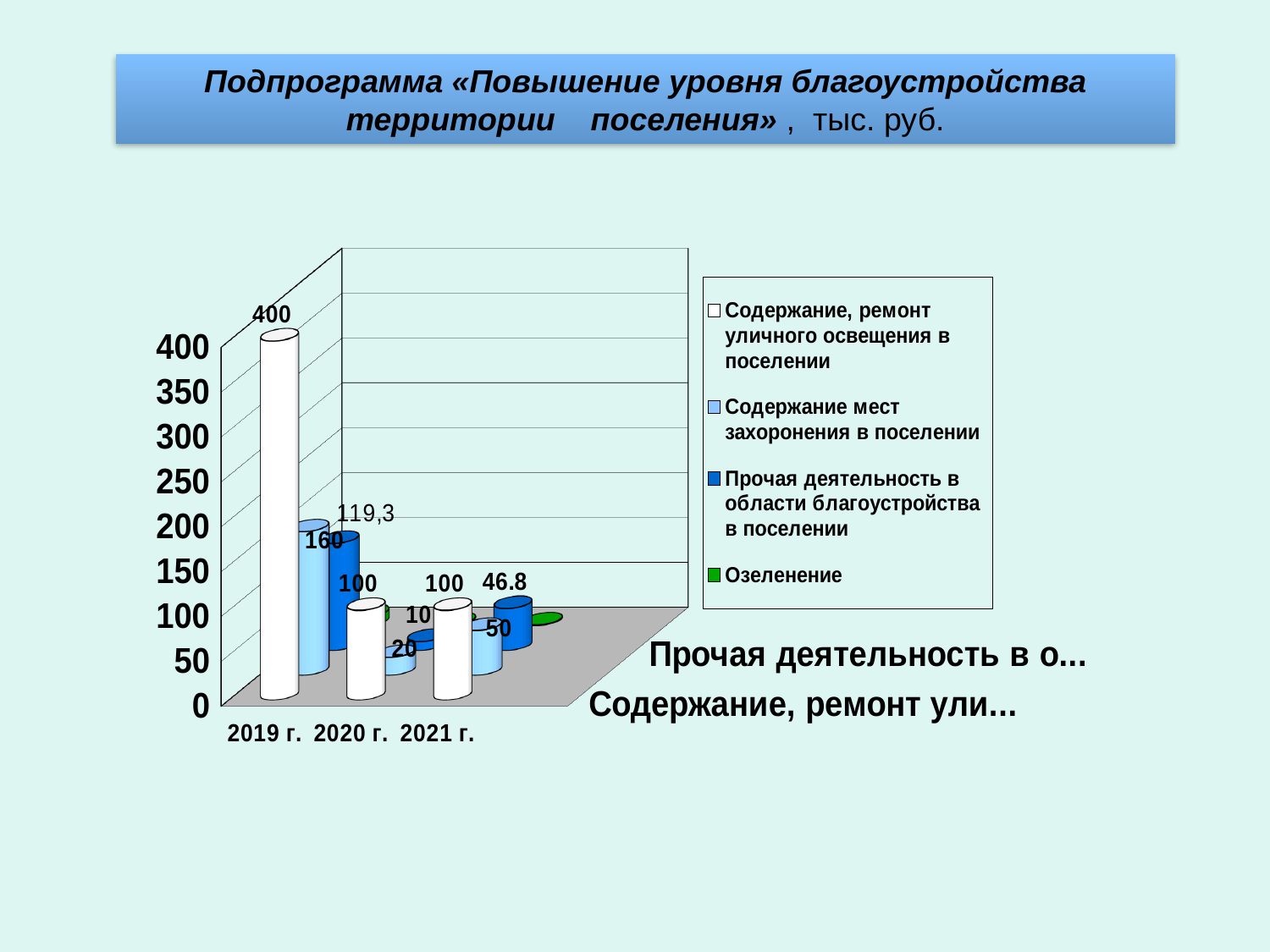
What is the value for «Прочая деятельность в области благоустройства в поселении» in 2019? 119,3 What is the value for «Содержание, ремонт уличного освещения в поселении» in 2019? 400 What is the difference between the 2019 and 2020 values for «Содержание, ремонт уличного освещения в поселении»? 300 What is the value for «Прочая деятельность в области благоустройства в поселении» in 2021? 46.8 What is the value for «Содержание мест захоронения в поселении» in 2021? 50 How many years are shown on the x axis? 3 What is the value for «Содержание, ремонт уличного освещения в поселении» in 2020? 100 What is the value for «Содержание мест захоронения в поселении» in 2019? 160 In 2019, which is larger: «Содержание мест захоронения в поселении» or «Прочая деятельность в области благоустройства в поселении»? Содержание мест захоронения в поселении In which year is the value for «Содержание, ремонт уличного освещения в поселении» highest? 2019 г. How many series does the legend list? 4 What kind of chart is shown on the slide? bar chart